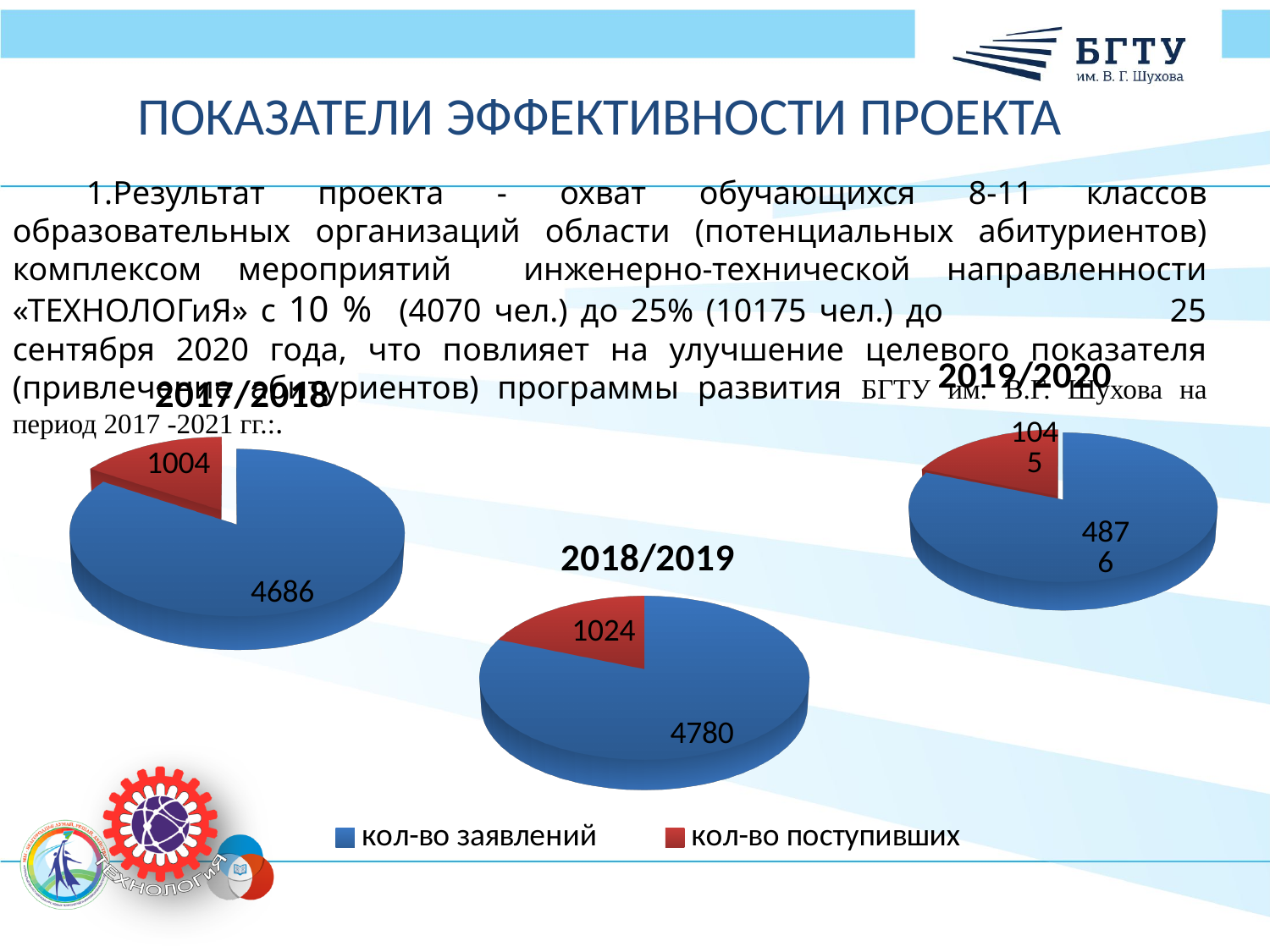
In the 2019/2020 pie chart, what is the value for кол-во поступивших? 1045 In the 2018/2019 pie chart, what is the value for кол-во заявлений? 4780 What type of chart is used for the 2018/2019 data? Pie chart In the 2018/2019 pie chart, what is the value for кол-во поступивших? 1024 In the 2017/2018 pie chart, what is the difference between кол-во заявлений and кол-во поступивших? 3682 In the 2017/2018 pie chart, what is the value for кол-во поступивших? 1004 In the 2018/2019 pie chart, which slice is larger, кол-во заявлений or кол-во поступивших? кол-во заявлений In the 2018/2019 pie chart, what is the total of the two slices? 5804 In the 2019/2020 pie chart, what is the value for кол-во заявлений? 4876 How many series does the legend list? 2 How many pie charts are shown on the slide? 3 In the 2017/2018 pie chart, what is the value for кол-во заявлений? 4686